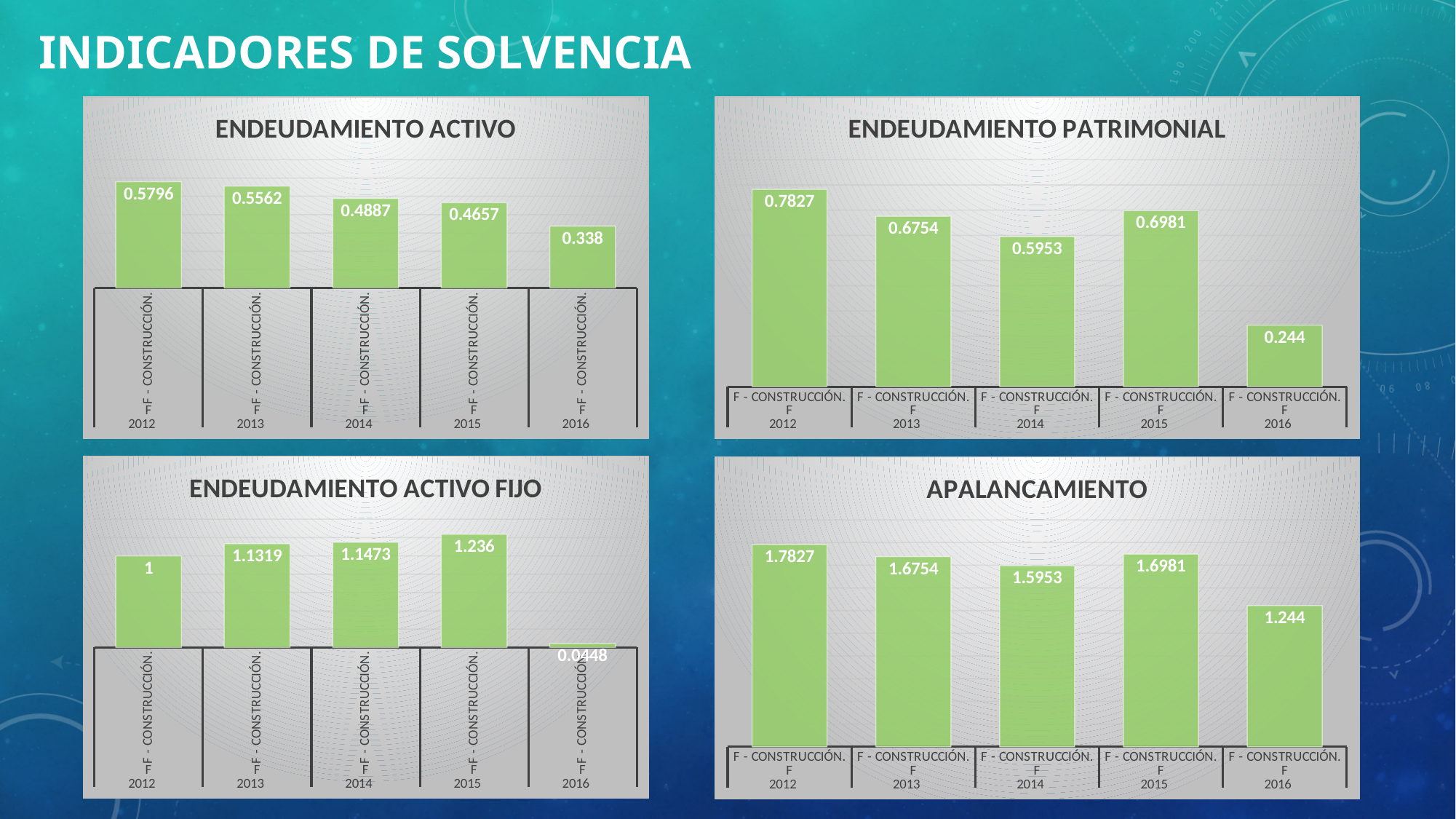
In the ENDEUDAMIENTO ACTIVO chart, which year has the lowest value? 2016 In the ENDEUDAMIENTO ACTIVO FIJO chart, what is the value for 2016? 0.0448 In the ENDEUDAMIENTO ACTIVO chart, do the values rise or fall from 2012 to 2016? fall In the ENDEUDAMIENTO PATRIMONIAL chart, what is the difference between the 2012 and 2016 values? 0.5387 In the APALANCAMIENTO chart, what is the value for 2013? 1.6754 In the ENDEUDAMIENTO ACTIVO FIJO chart, which year has the highest value? 2015 In the ENDEUDAMIENTO ACTIVO chart, what is the value for 2014? 0.4887 In the ENDEUDAMIENTO PATRIMONIAL chart, which year has the highest value? 2012 How many bars does the APALANCAMIENTO chart have? 5 What type of chart is the ENDEUDAMIENTO ACTIVO FIJO chart? bar chart In the APALANCAMIENTO chart, which is larger, the value for 2014 or the value for 2015? 2015 In the ENDEUDAMIENTO PATRIMONIAL chart, what is the value for 2015? 0.6981